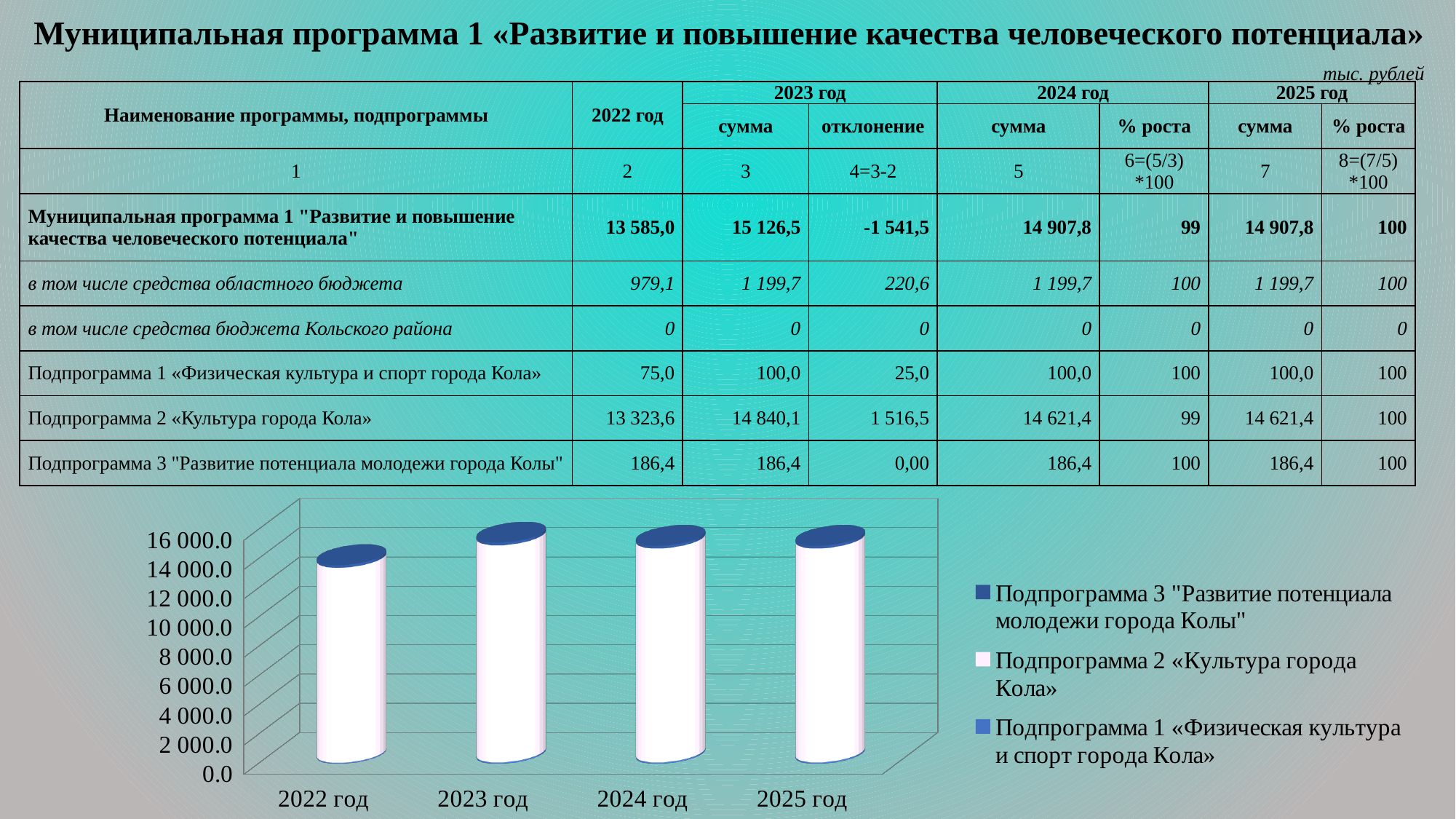
How many year categories are shown on the x axis of the chart? 4 What is the highest value labelled on the chart's vertical axis? 16 000.0 Is the total height of the bar for 2022 год greater or less than 12 000.0? greater Which of the two bars is taller: 2022 год or 2023 год? 2023 год Which series in the legend is shown in white? Подпрограмма 2 «Культура города Кола» Is the total height of the bar for 2024 год greater or less than 14 000.0? greater What kind of chart is shown at the bottom of the slide? bar chart Which year has the tallest stacked bar in the chart? 2023 год Which year has the shortest stacked bar in the chart? 2022 год Does the total bar height rise or fall from 2022 год to 2023 год? rises How many series does the chart legend list? 3